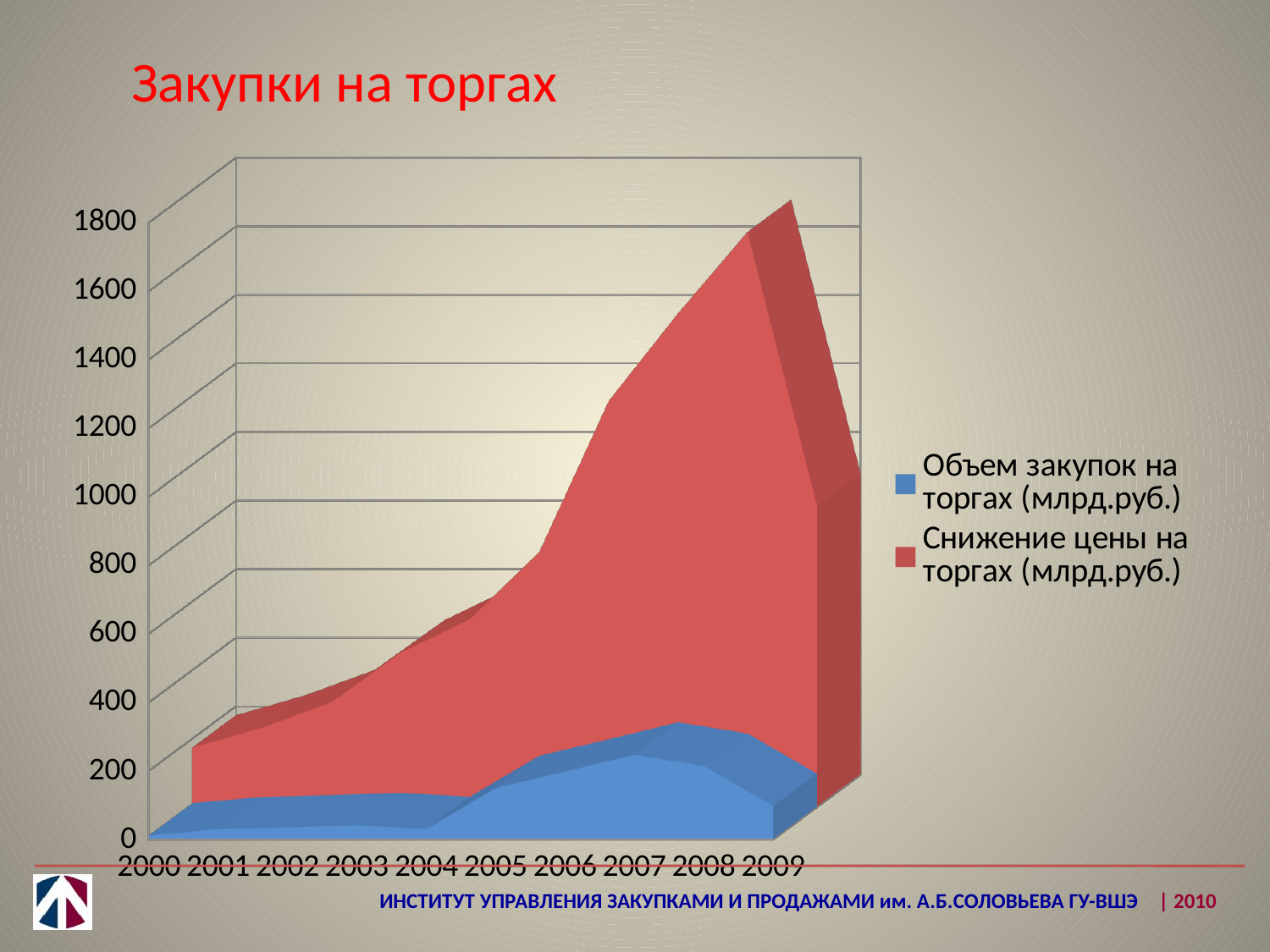
Which is larger in 2009: Объем закупок на торгах (млрд.руб.) or Снижение цены на торгах (млрд.руб.)? Снижение цены на торгах (млрд.руб.) In which year is the value for Снижение цены на торгах (млрд.руб.) lowest? 2000 Which series is shown in red? Снижение цены на торгах (млрд.руб.) What is the title of the chart? Закупки на торгах How many years are shown along the x axis? 10 Is the value for Объем закупок на торгах (млрд.руб.) in 2009 greater or less than 400? less Does the value for Снижение цены на торгах (млрд.руб.) rise or fall from 2000 to 2009? rise What kind of chart is shown on the slide? area chart Is the value for Снижение цены на торгах (млрд.руб.) in 2000 greater or less than 400? less In which year is the value for Снижение цены на торгах (млрд.руб.) highest? 2008 How many series does the legend list? 2